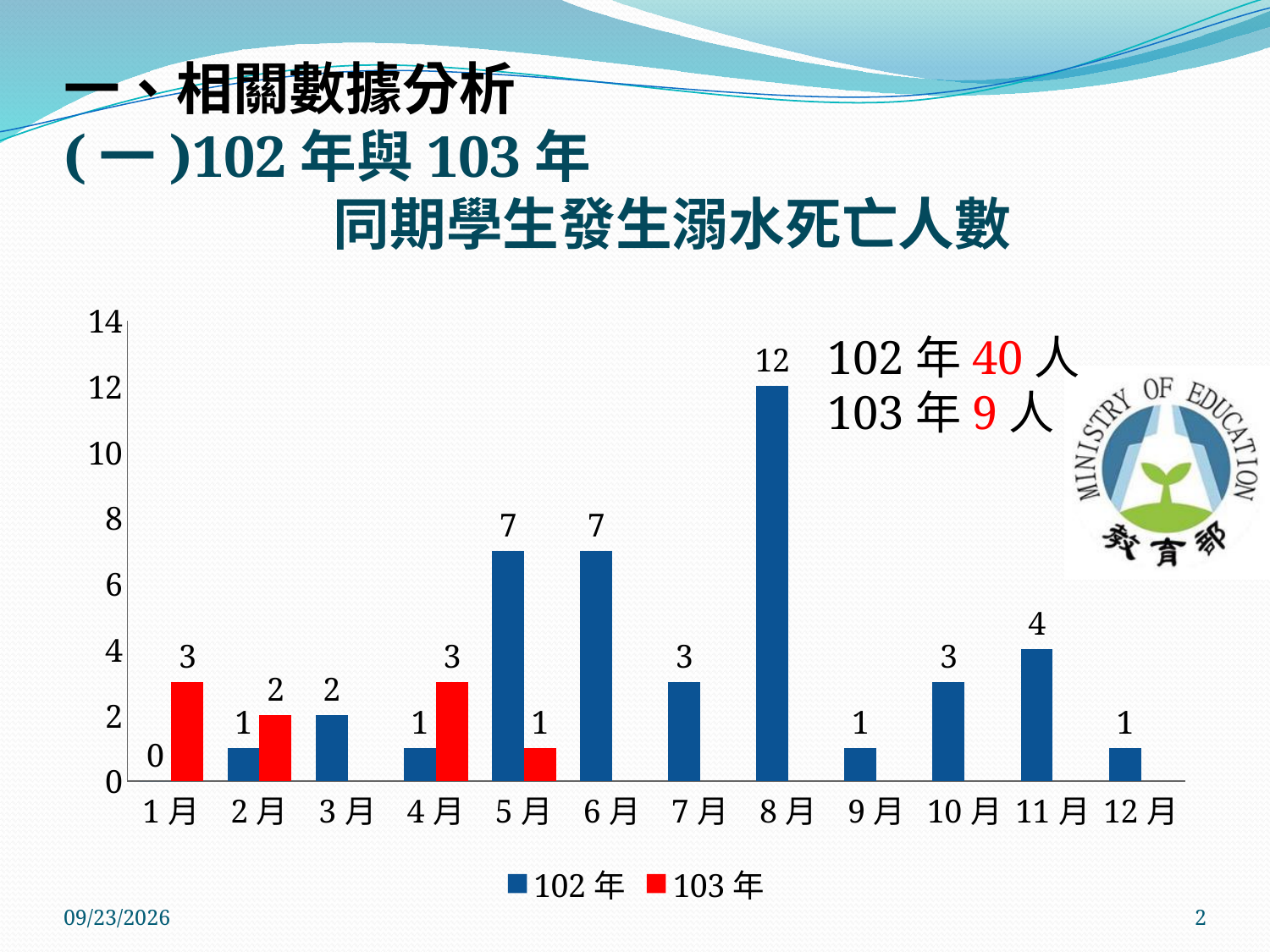
What is the value for 102年 in 8月? 12 What is the difference between the 103年 value and the 102年 value in 1月? 3 How many months are shown on the x axis? 12 What is the value for 103年 in 1月? 3 In 4月, which series has the larger value, 102年 or 103年? 103年 What is the difference between the 102年 value in 8月 and the 102年 value in 5月? 5 What type of chart is shown on the slide? bar chart How many series does the legend list? 2 What is the value for 102年 in 11月? 4 Which month has the highest value for 102年? 8月 Which month has the lowest value for 102年? 1月 Which colour represents the 103年 series in the legend? red